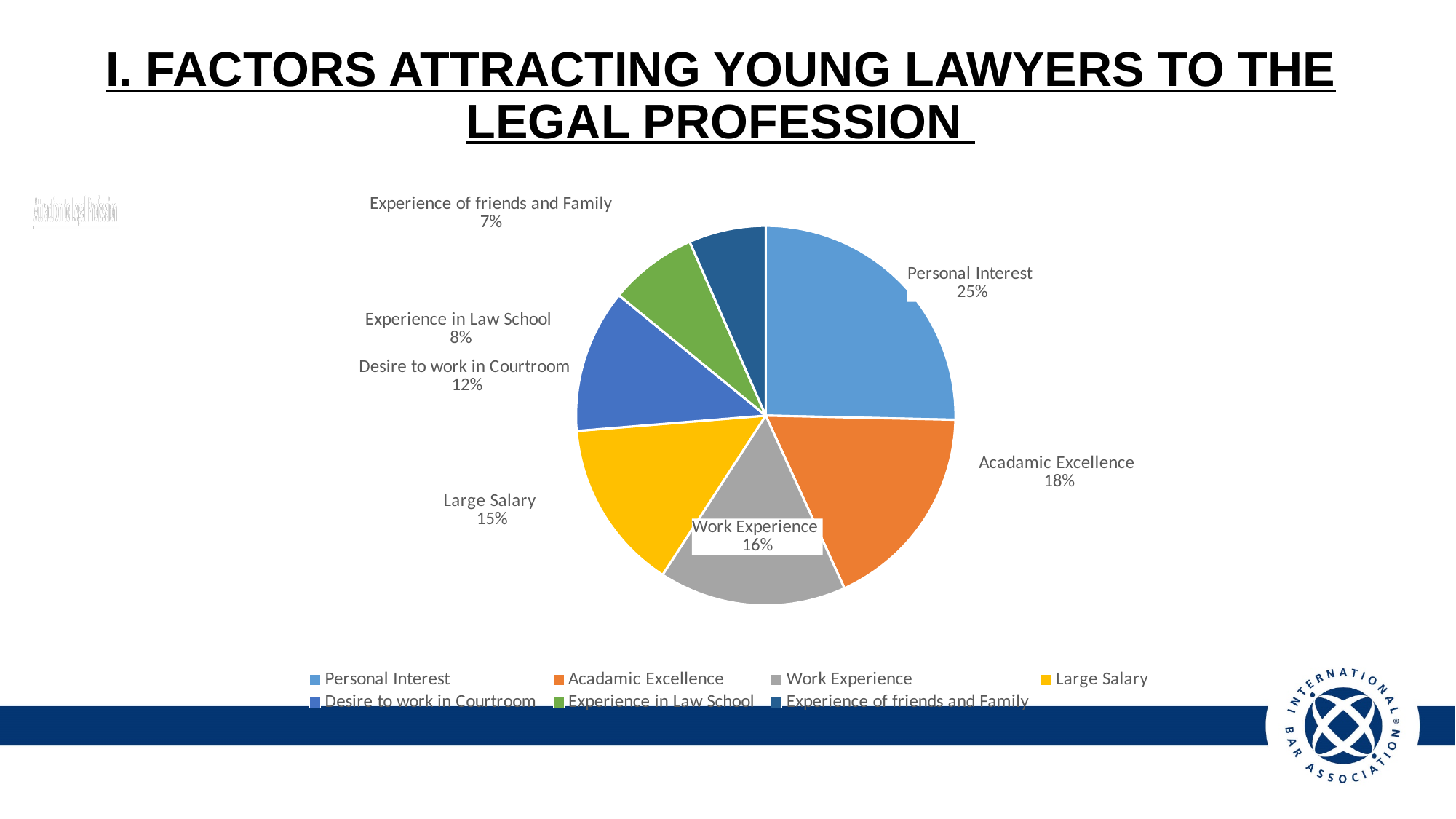
Which factor has the smallest slice of the pie? Experience of friends and Family What kind of chart is shown on the slide? pie chart What percentage is shown for Work Experience? 16% Which factor has the largest slice of the pie? Personal Interest What percentage is shown for Experience of friends and Family? 7% How many slices does the pie chart have? 7 What share of the pie does Personal Interest account for? 25% What percentage is shown for Desire to work in Courtroom? 12% What percentage is shown for Acadamic Excellence? 18% What is the difference in percentage points between Personal Interest and Experience in Law School? 17 Which is larger, the share for Large Salary or the share for Desire to work in Courtroom? Large Salary What percentage is shown for Large Salary? 15%